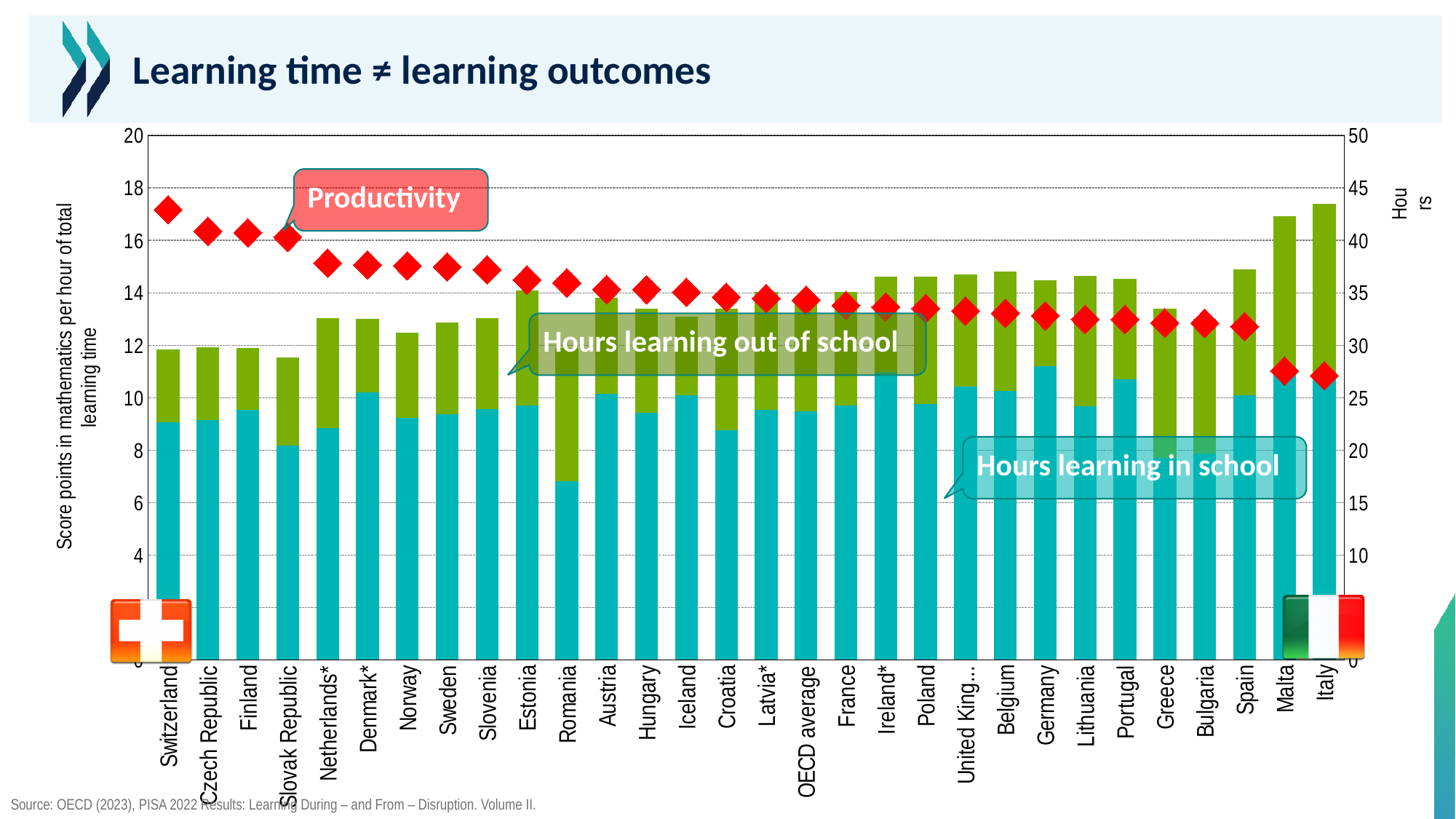
Which has higher productivity, Switzerland or Italy? Switzerland Is the total hours of learning for Italy greater or less than 40? greater Is the hours learning in school value for Romania greater or less than 20? less Do the productivity values generally rise or fall moving from left to right along the x axis? fall Which country has the highest productivity (score points per hour of total learning time)? Switzerland Which country has the highest total hours of learning (in school plus out of school)? Italy What is the title of the chart on this slide? Learning time ≠ learning outcomes How many data series are labelled on the chart? 3 Is the productivity value for Italy greater or less than 12? less How many countries/categories are shown along the x axis? 30 What kind of chart is shown on the slide? Stacked bar chart with productivity markers